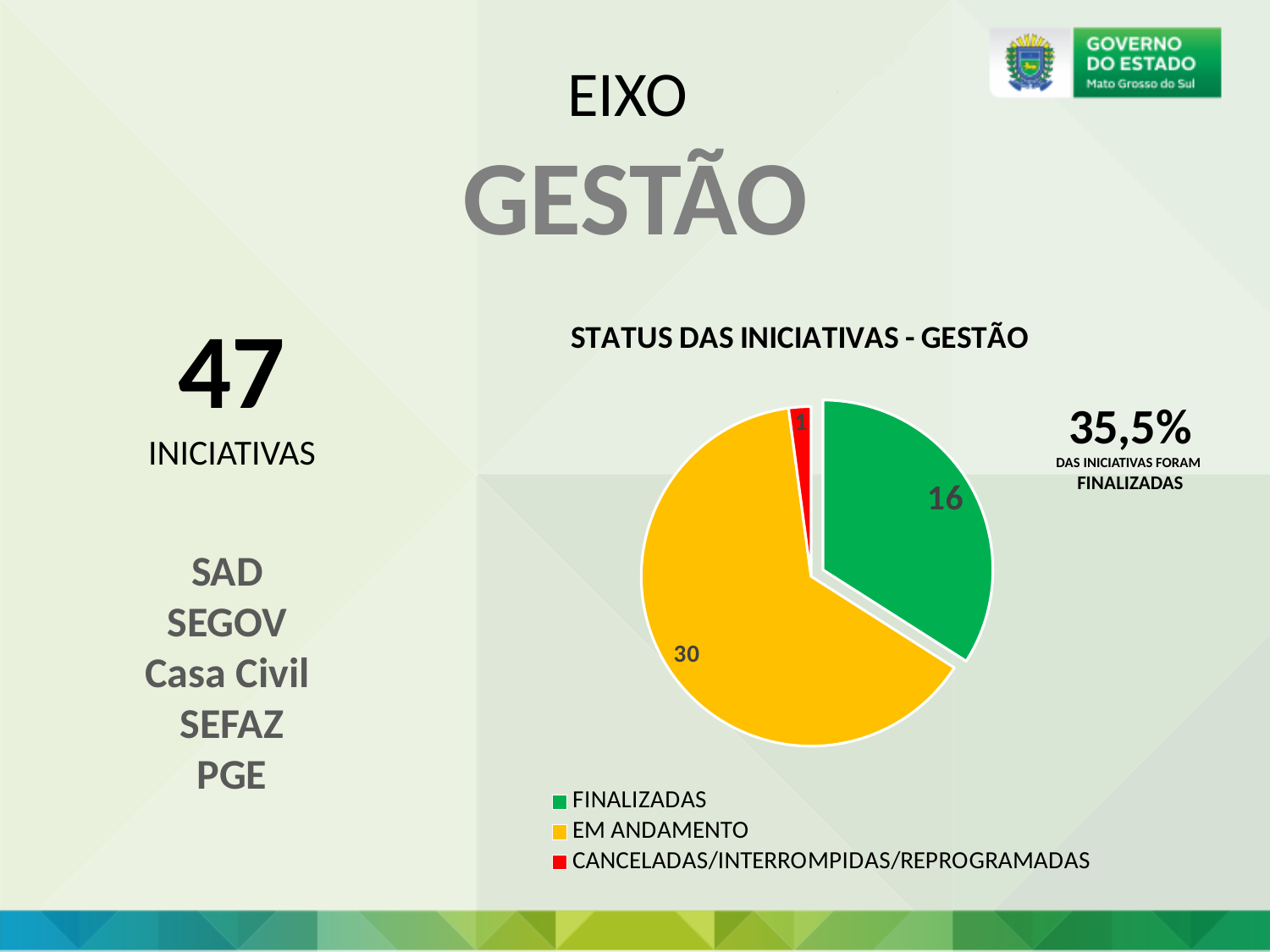
What is the difference between the EM ANDAMENTO and FINALIZADAS values? 14 What is the value for FINALIZADAS? 16 What type of chart is shown on the slide? pie chart What is the value for EM ANDAMENTO? 30 Which category has the largest slice? EM ANDAMENTO How many entries does the legend list? 3 What is the value for CANCELADAS/INTERROMPIDAS/REPROGRAMADAS? 1 Which category has the smallest slice? CANCELADAS/INTERROMPIDAS/REPROGRAMADAS How many slices does the pie chart have? 3 What colour is the EM ANDAMENTO slice? yellow Which is larger, FINALIZADAS or EM ANDAMENTO? EM ANDAMENTO What is the title of the chart? STATUS DAS INICIATIVAS - GESTÃO